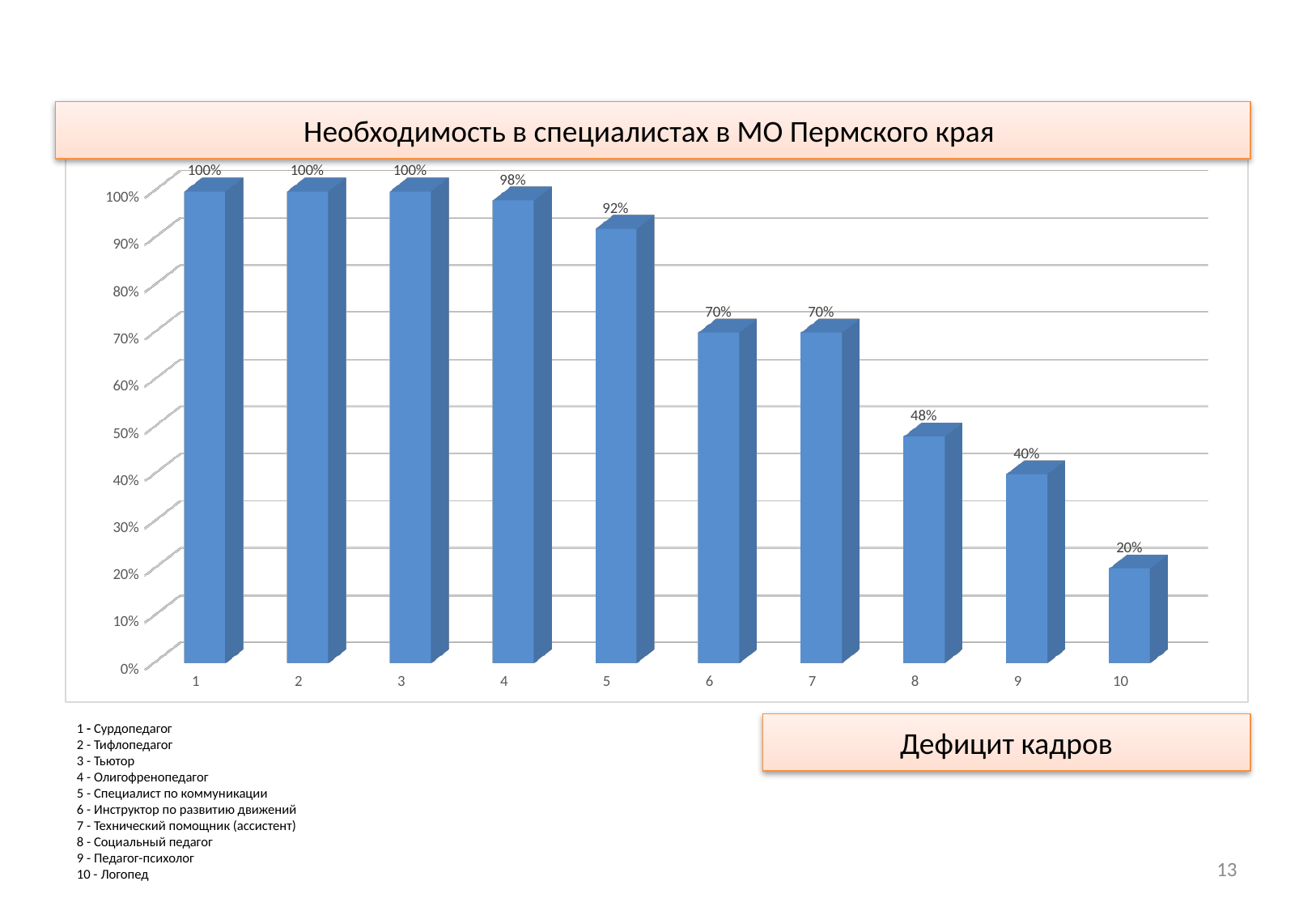
What is the difference between the values for category 5 and category 6? 22% What is the value for category 10 (Логопед)? 20% What is the value for category 4 (Олигофренопедагог)? 98% What is the value for category 5 (Специалист по коммуникации)? 92% Do the values rise or fall from category 1 to category 10? Fall What is the difference between the values for category 8 and category 9? 8% What kind of chart is shown on the slide? Bar chart Which category has the lowest value? 10 (Логопед) Which is larger, the value for category 7 or the value for category 8? Category 7 How many categories are shown on the x axis? 10 What is the title of the chart? Необходимость в специалистах в МО Пермского края What is the value for category 8 (Социальный педагог)? 48%